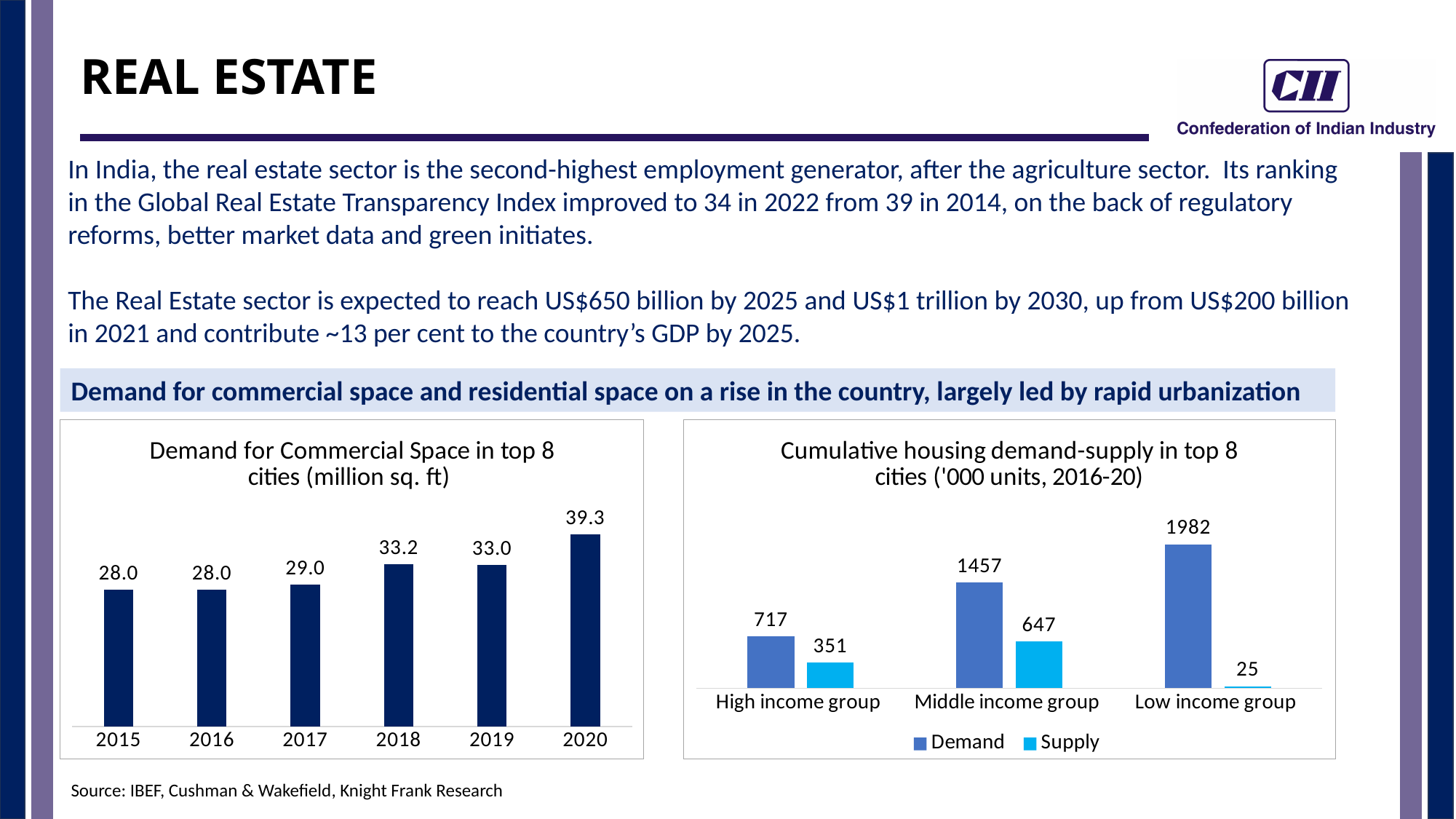
In the 'Demand for Commercial Space in top 8 cities' chart, what is the difference between the 2020 and 2015 values? 11.3 In the 'Cumulative housing demand-supply in top 8 cities' chart, what is the difference between Demand and Supply for the High income group? 366 What kind of chart is the 'Demand for Commercial Space in top 8 cities' chart? Bar chart In the 'Cumulative housing demand-supply in top 8 cities' chart, which group has the highest Demand? Low income group In the 'Cumulative housing demand-supply in top 8 cities' chart, which is larger: Supply for the Middle income group or Supply for the High income group? Middle income group In the 'Demand for Commercial Space in top 8 cities' chart, how many years are shown? 6 In the 'Cumulative housing demand-supply in top 8 cities' chart, what is the Demand value for the Middle income group? 1457 In the 'Demand for Commercial Space in top 8 cities' chart, what is the value for 2020? 39.3 In the 'Cumulative housing demand-supply in top 8 cities' chart, what is the Supply value for the Low income group? 25 In the 'Demand for Commercial Space in top 8 cities' chart, which year has the highest value? 2020 In the 'Demand for Commercial Space in top 8 cities' chart, what is the value for 2018? 33.2 In the 'Cumulative housing demand-supply in top 8 cities' chart, how many series does the legend list? 2